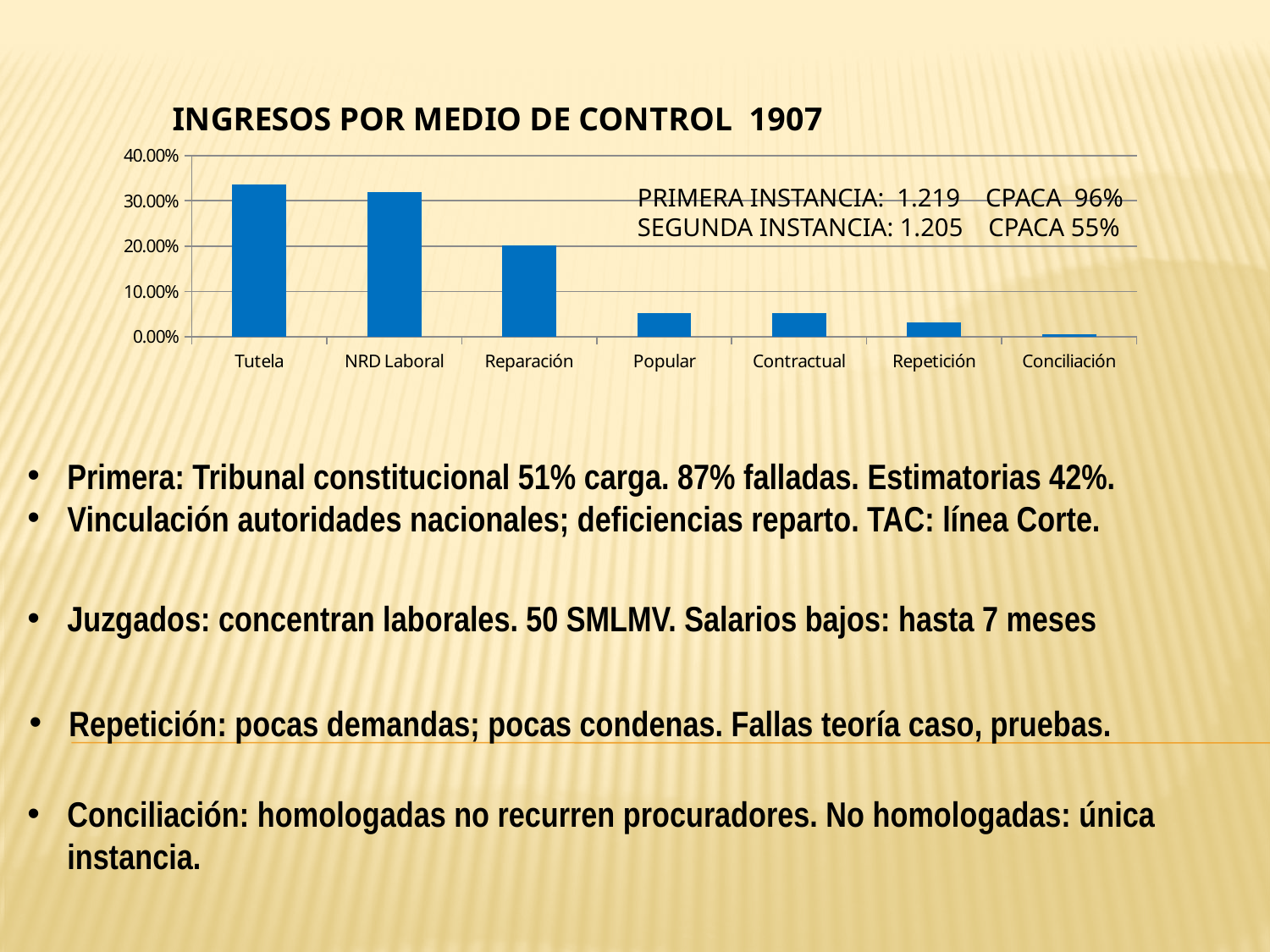
Which has a larger value, Reparación or Popular? Reparación What is the title of the chart? INGRESOS POR MEDIO DE CONTROL 1907 Do the values rise or fall moving from left to right along the x axis? Fall Which category has the lowest value in the chart? Conciliación Is the value for Repetición greater or less than 10.00%? less Is the value for Tutela greater or less than 30.00%? greater Which category has the highest value in the chart? Tutela Which has a larger value, Tutela or NRD Laboral? Tutela How many categories are shown on the x axis of the chart? 7 Is the value for NRD Laboral greater or less than 20.00%? greater What kind of chart is shown on the slide? Bar chart